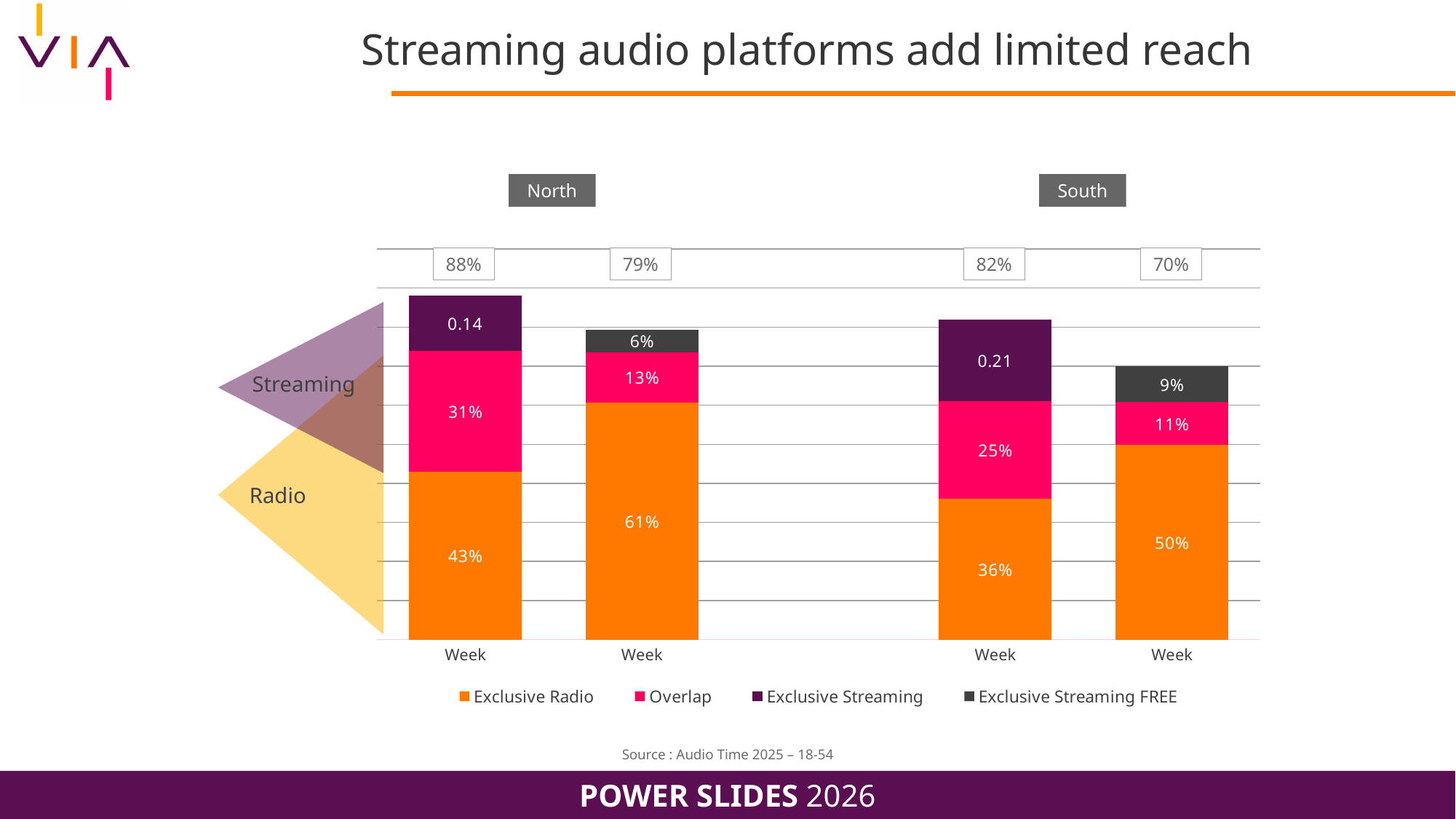
What is the Exclusive Radio value for the first (left) North bar? 43% What total is shown above the second (right) South bar? 70% Which bar has the lowest total shown above it? the second (right) South bar Which is larger, the Exclusive Radio value of the second North bar or the second South bar? the second North bar How many series does the legend list? 4 Which bar has the highest Exclusive Radio value? the second (right) North bar What total is shown above the first (left) North bar? 88% What type of chart is shown on the slide? stacked bar chart What is the Exclusive Streaming value shown on the first (left) South bar? 0.21 What is the difference between the Overlap values of the first North bar and the first South bar? 6% What is the Exclusive Streaming FREE value for the second (right) South bar? 9% What is the Overlap value for the second (right) North bar? 13%